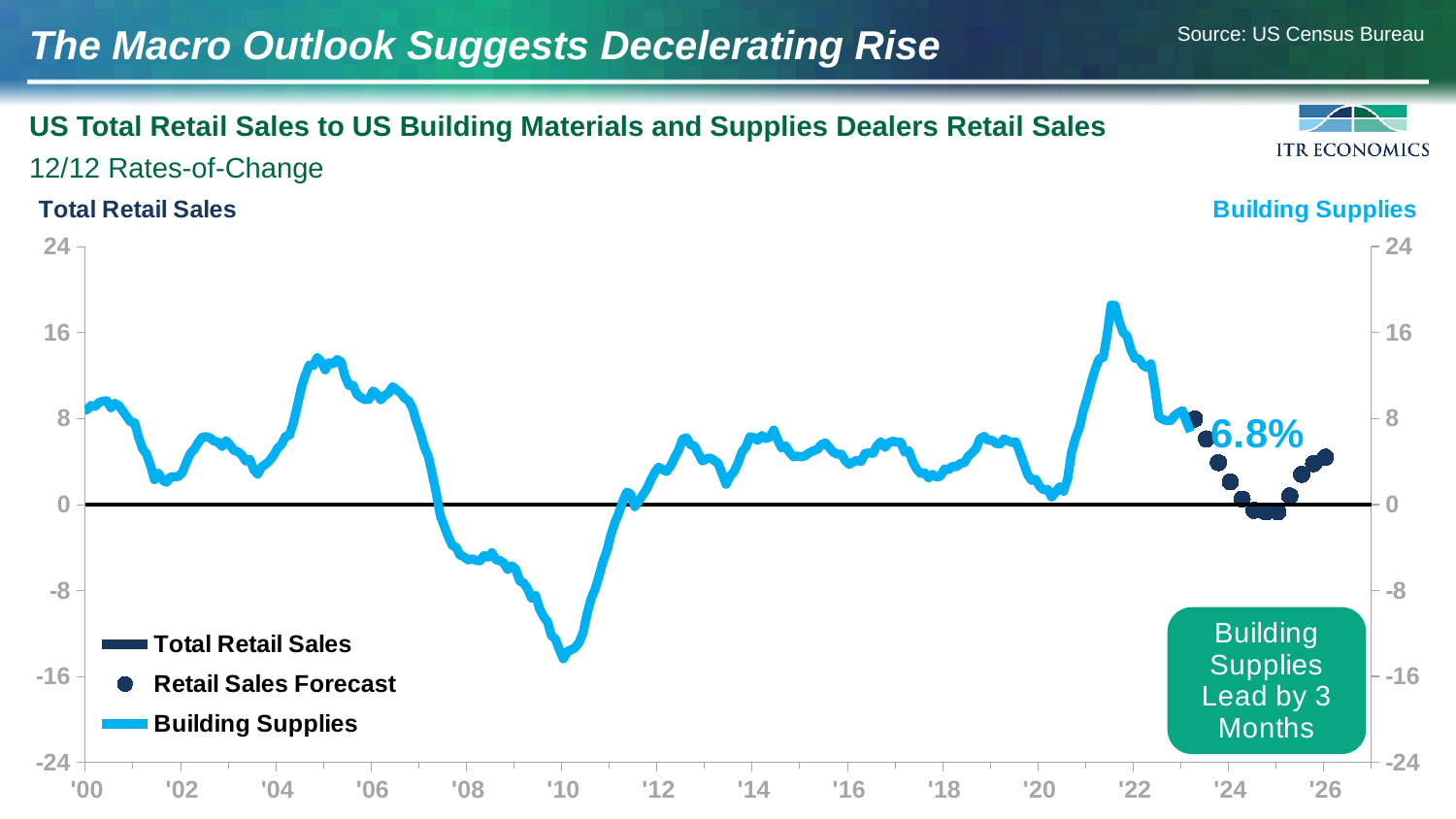
Is the peak value of the Building Supplies line around 2021–2022 greater or less than 16? greater What kind of chart is shown on the slide? line chart Does the Building Supplies line rise or fall between '10 and '12? rise Near which x-axis year label does the Building Supplies line reach its lowest point? '10 What value is printed as a data label near the start of the Retail Sales Forecast dots? 6.8% Is the lowest value of the Building Supplies line around 2010 greater or less than -8? less Does the Building Supplies line rise or fall between '08 and '10? fall Is the value of the Building Supplies line around 2020 greater or less than 8? less How many series does the legend list? 3 Which is higher: the Building Supplies peak around 2021–2022 or the peak around 2005? the peak around 2021–2022 What does the green box on the chart say? Building Supplies Lead by 3 Months